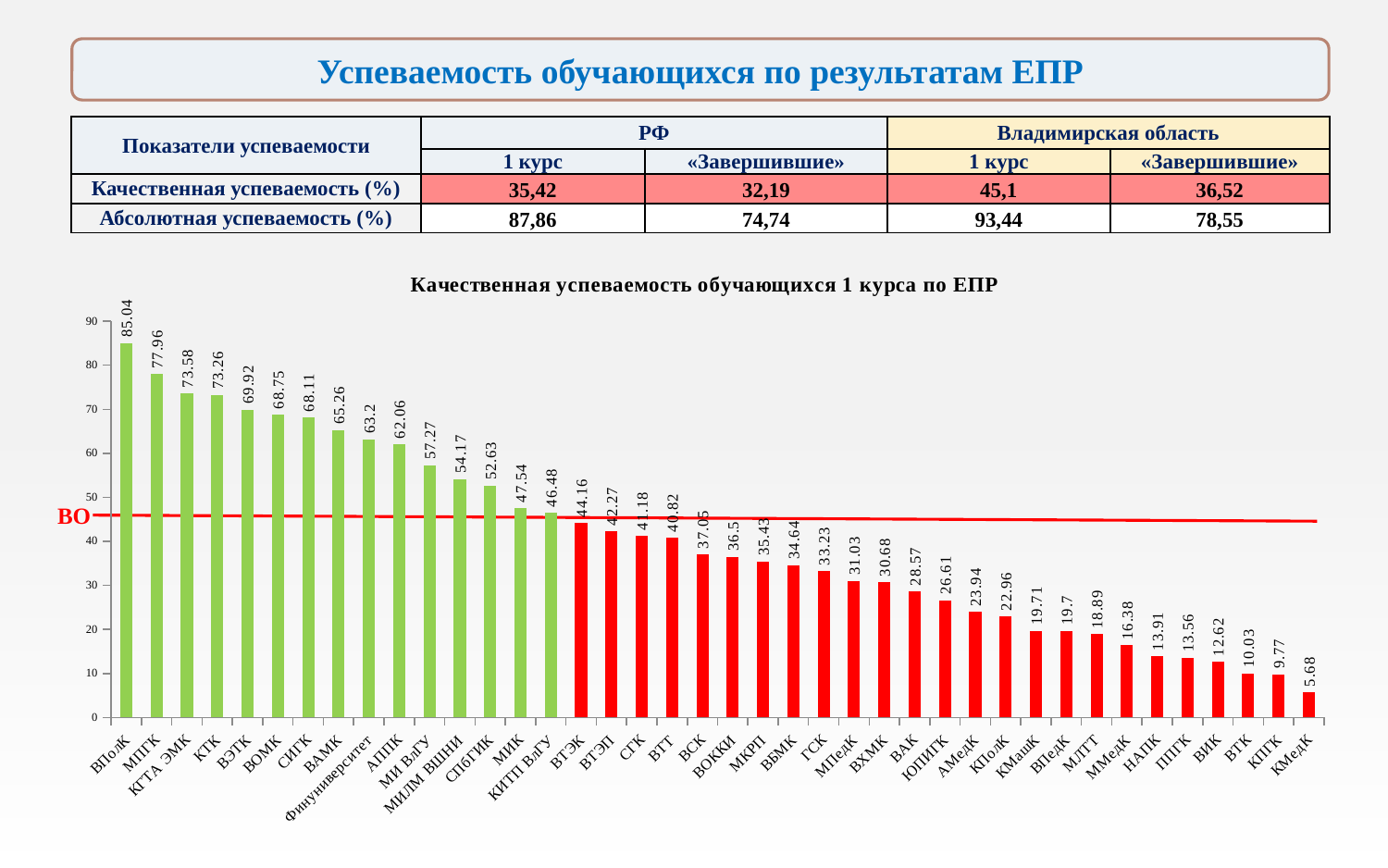
What is the value for СПбГИК in the chart? 52.63 Which is larger, the value for ВЭТК or the value for ВСК? ВЭТК Is the value for ГСК greater or less than 40? less What is the difference between the values for МПГК and ВТЭК? 33.8 Do the values rise or fall from left to right along the x axis? fall What is the value for ВАК in the chart? 28.57 What is the value for ВПолК in the chart? 85.04 What is the difference between the values for ВПолК and КМедК? 79.36 What kind of chart is shown on the slide? bar chart Which category has the highest value in the chart? ВПолК Which category has the lowest value in the chart? КМедК How many categories are shown on the x axis of the chart? 40